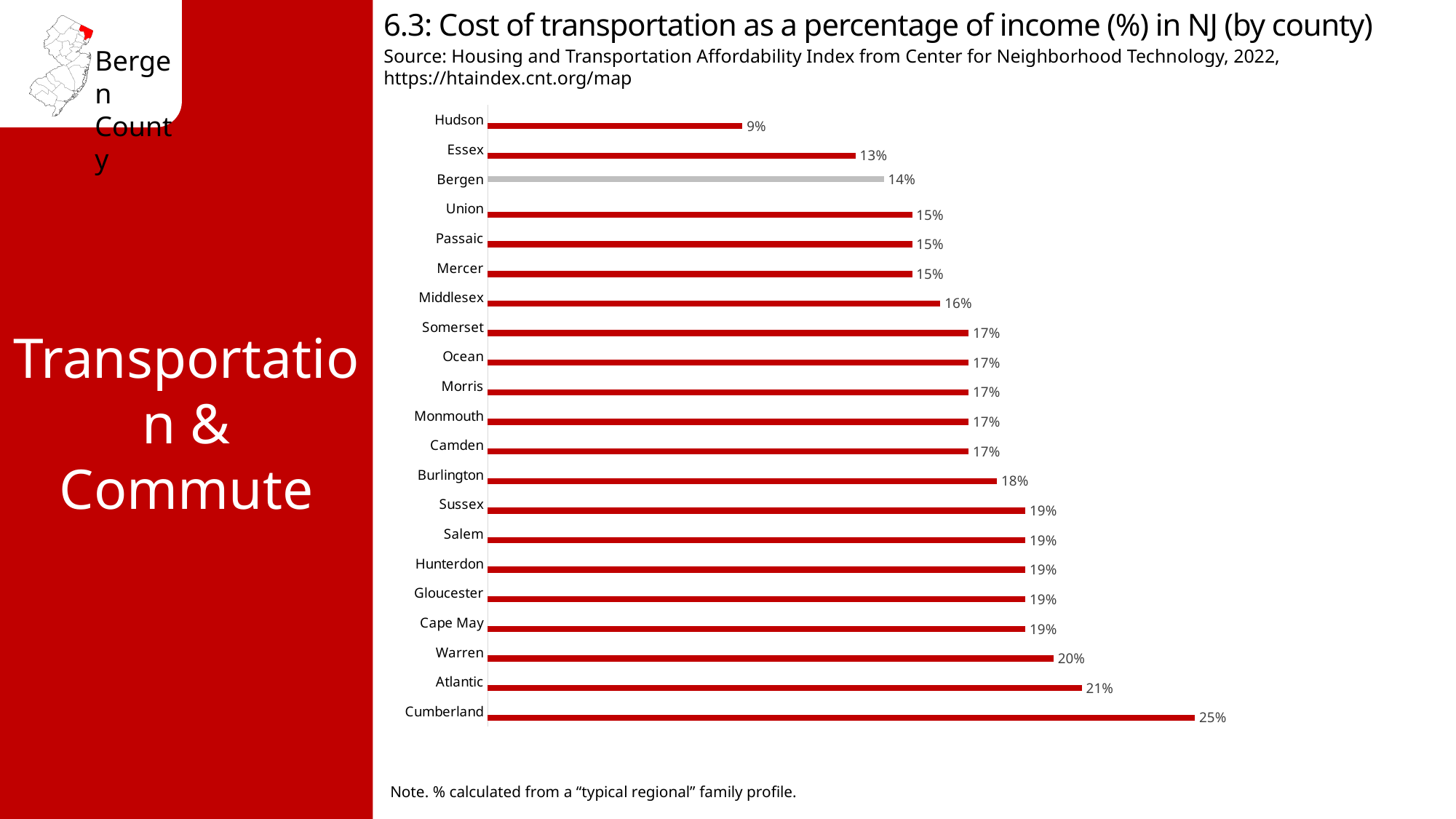
What is the value shown for Hudson County? 9% What is the difference between the values for Atlantic and Bergen? 7% Which county has the lowest cost of transportation as a percentage of income? Hudson What is the cost of transportation as a percentage of income for Bergen County? 14% Which county's bar is shown in grey rather than red? Bergen Which county has the highest cost of transportation as a percentage of income? Cumberland What is the difference between the values for Cumberland and Hudson? 16% What kind of chart is shown on the slide? Bar chart What is the cost of transportation as a percentage of income for Cumberland County? 25% Which has a higher value, Essex or Middlesex? Middlesex What is the value shown for Warren County? 20% How many counties are shown in the chart? 21